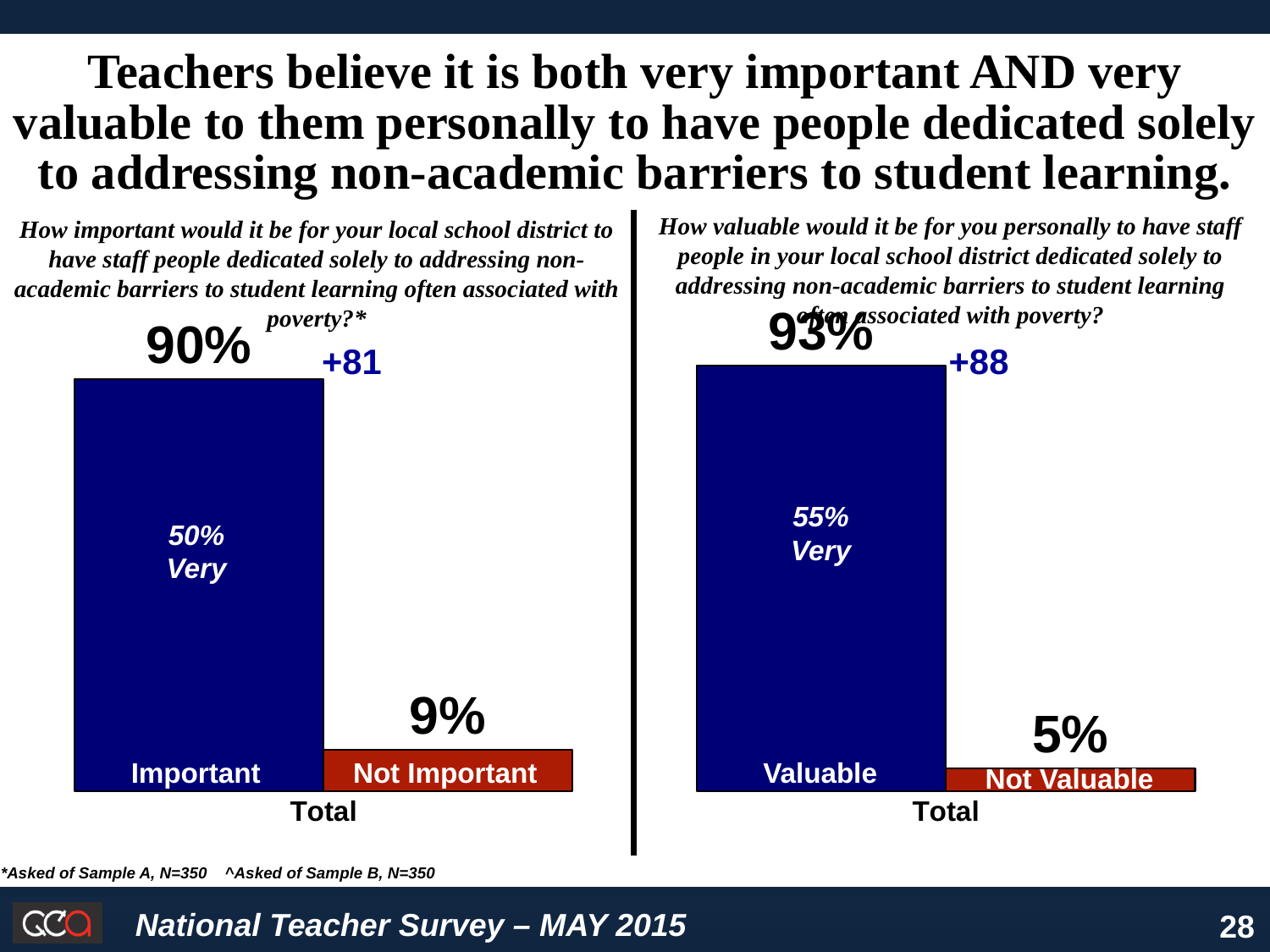
In the left chart, what percentage of teachers say it is very important? 50% In the right chart, what percentage of teachers say it is not valuable? 5% In the left chart, what is the difference between the Important and Not Important percentages? 81 In the right chart, what percentage of teachers say it is very valuable? 55% In the right chart, what percentage of teachers say it is valuable? 93% In the left chart, what percentage of teachers say it is not important? 9% How many bars are shown in the right chart? 2 In the right chart, which bar is taller, Valuable or Not Valuable? Valuable In the right chart, what is the difference between the Valuable and Not Valuable percentages? 88 In the left chart, which category has the lowest value? Not Important What type of chart is the left chart? Bar chart In the left chart, what percentage of teachers say it is important? 90%